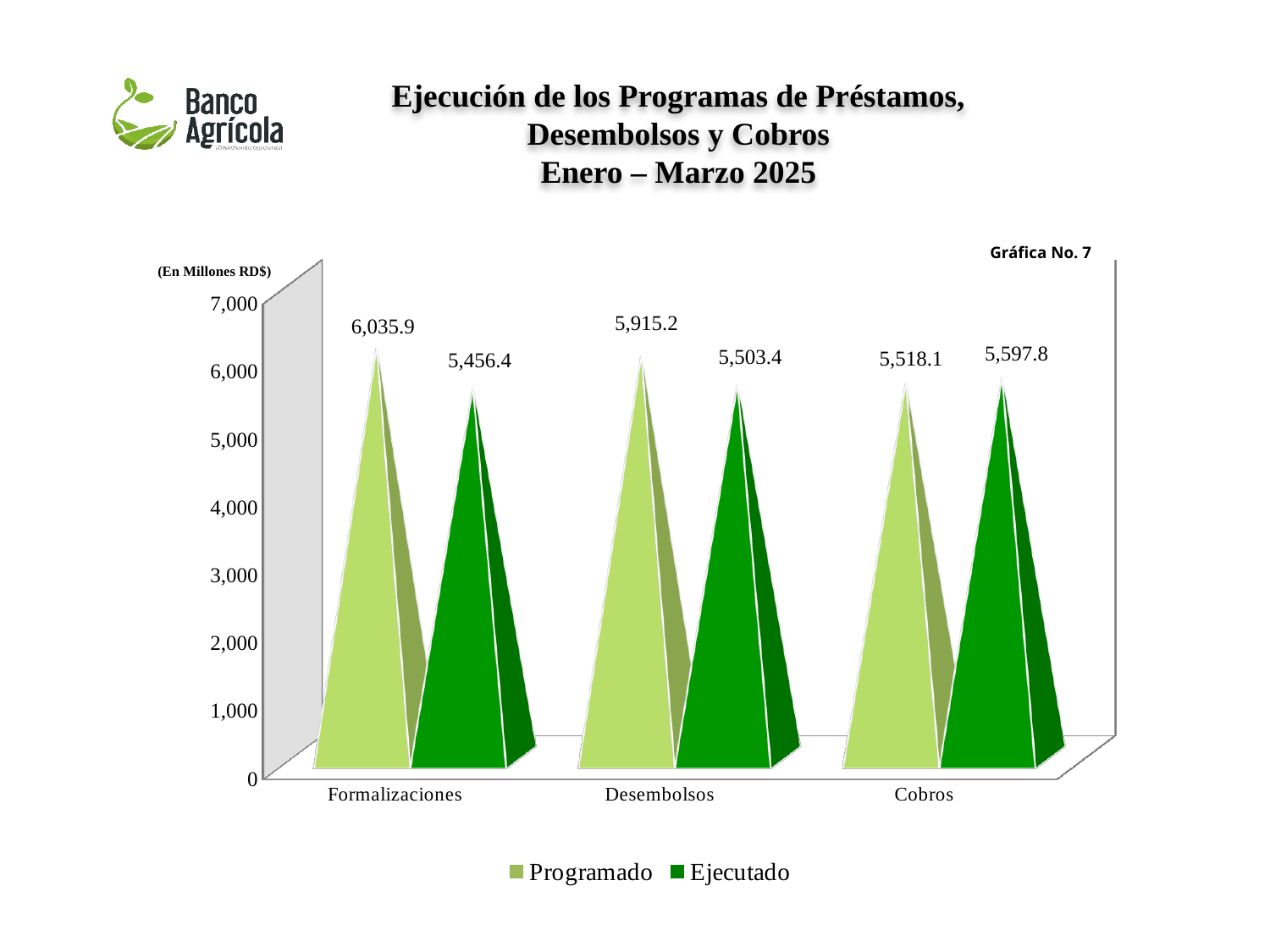
How many categories are shown on the x axis? 3 Which category has the lowest Ejecutado value? Formalizaciones What is the Ejecutado value for Cobros? 5,597.8 What is the Ejecutado value for Desembolsos? 5,503.4 What kind of chart is shown on the slide? Bar chart What is the difference between the Programado and Ejecutado values for Formalizaciones? 579.5 What unit is indicated for the values in the chart? En Millones RD$ Which category has the highest Programado value? Formalizaciones For Cobros, which is larger: the Programado value or the Ejecutado value? Ejecutado What is the difference between the Programado and Ejecutado values for Desembolsos? 411.8 What is the Programado value for Formalizaciones? 6,035.9 How many series does the legend list? 2